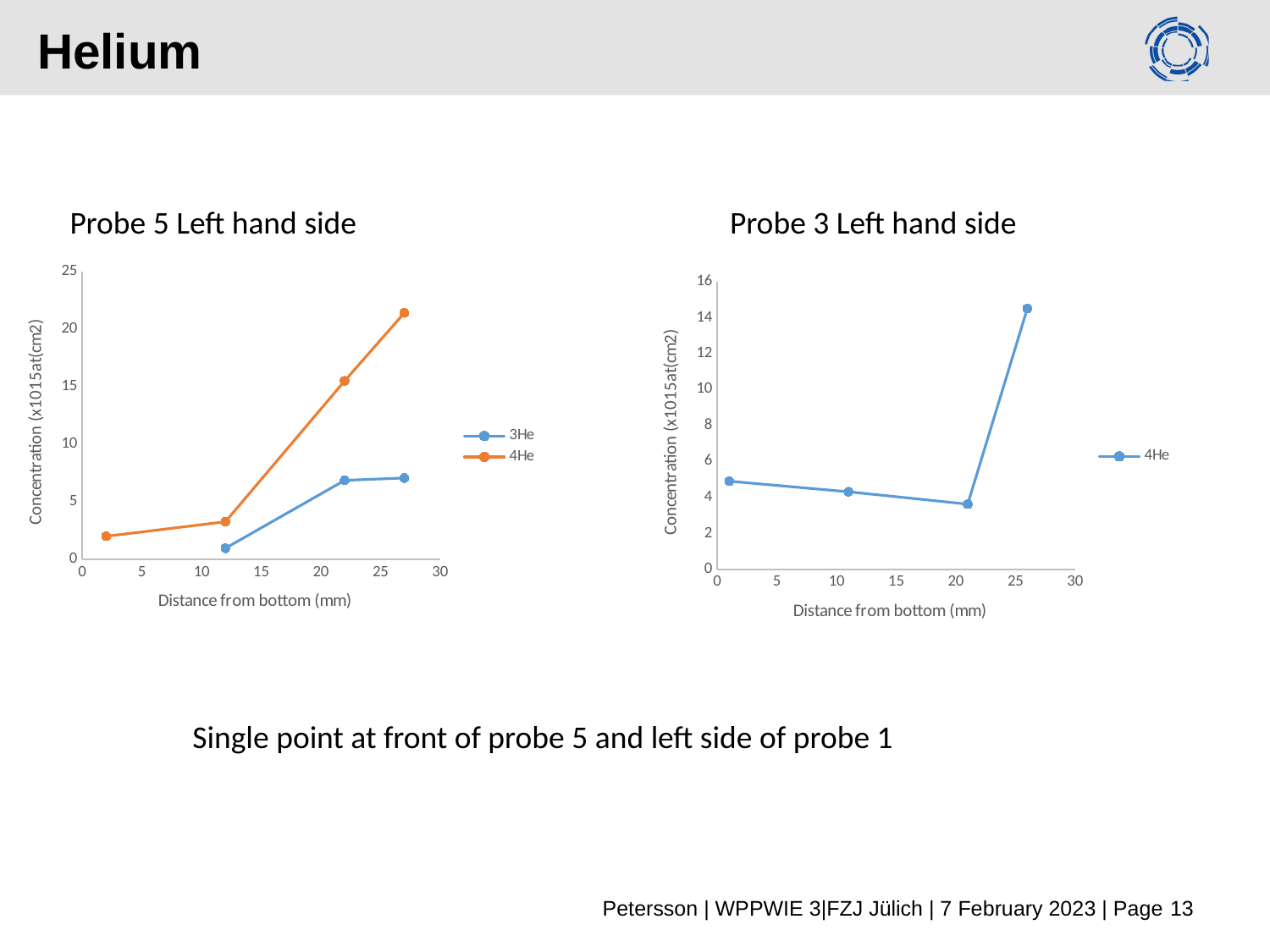
What kind of chart is the 'Probe 5 Left hand side' chart? line chart In the 'Probe 3 Left hand side' chart, does the 4He concentration rise or fall between 0 and 20 mm? fall In the 'Probe 3 Left hand side' chart, how many data points are plotted for 4He? 4 In the 'Probe 5 Left hand side' chart, is the 3He value at the largest distance greater or less than 10? less How many series does the legend of the 'Probe 3 Left hand side' chart list? 1 In the 'Probe 3 Left hand side' chart, is the 4He value at the largest distance greater or less than 10? greater In the 'Probe 5 Left hand side' chart, how many data points does the 4He series have? 4 What is the label of the x axis on the 'Probe 3 Left hand side' chart? Distance from bottom (mm) How many series does the legend of the 'Probe 5 Left hand side' chart list? 2 In the 'Probe 5 Left hand side' chart, how many data points does the 3He series have? 3 In the 'Probe 5 Left hand side' chart, is the 4He value at the largest distance greater or less than 20? greater In the 'Probe 5 Left hand side' chart, which series reaches the higher concentration, 3He or 4He? 4He